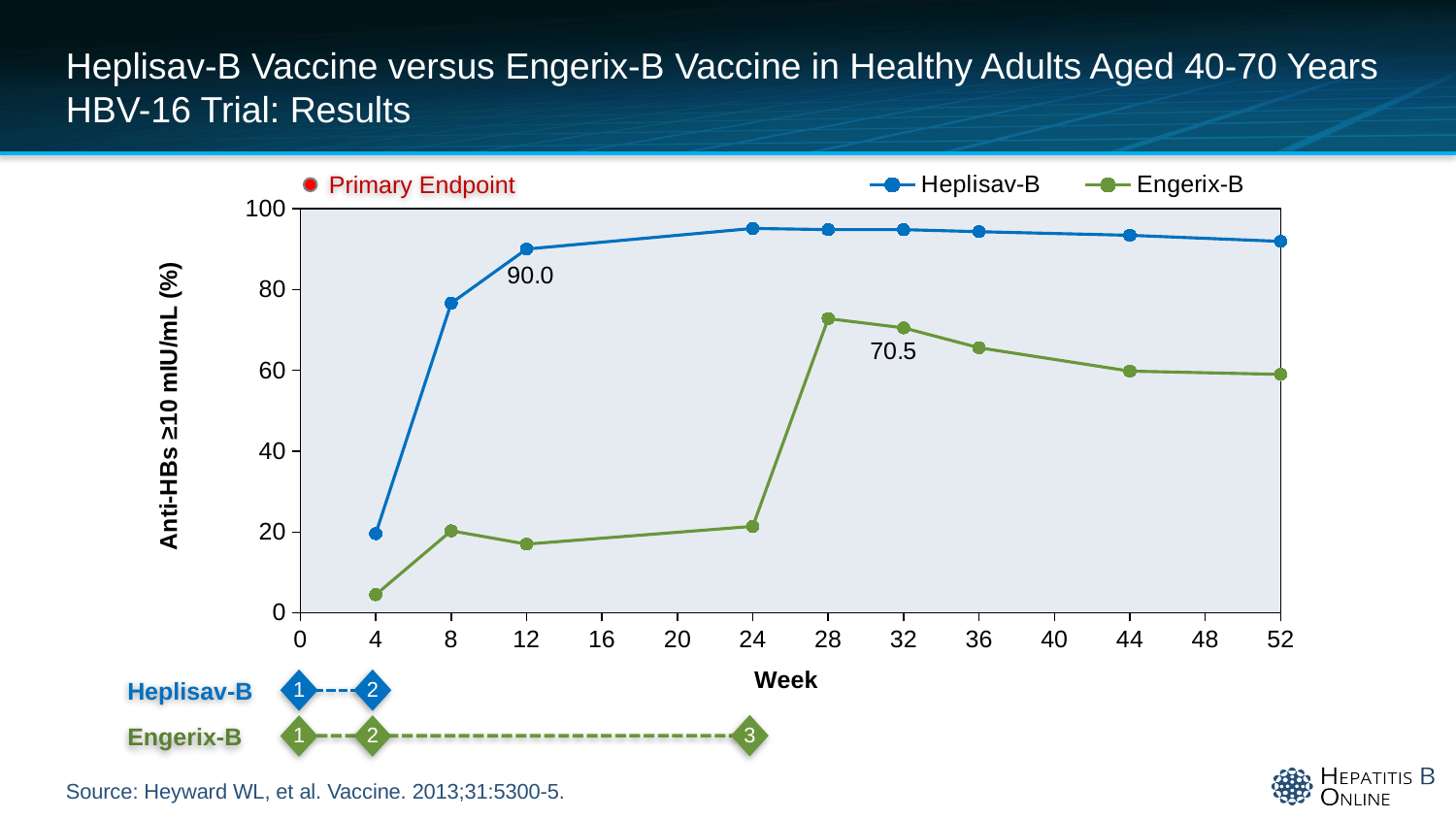
What is the difference between the labelled Heplisav-B value at week 12 (90.0) and the labelled Engerix-B value at week 32 (70.5)? 19.5 What is the labelled value for Heplisav-B at week 12? 90.0 Is the value for Engerix-B at week 28 greater or less than 60? greater What kind of chart is shown on the slide? line chart How many series does the legend list? 2 How many data points are plotted for the Heplisav-B series? 9 What is the labelled value for Engerix-B at week 32? 70.5 Is the value for Heplisav-B at week 24 greater or less than 80? greater At week 12, which series has the higher value, Heplisav-B or Engerix-B? Heplisav-B Is the value for Heplisav-B at week 4 greater or less than 40? less What is the label on the y axis of the chart? Anti-HBs ≥10 mIU/mL (%) Does the Engerix-B line rise or fall from week 28 to week 52? fall